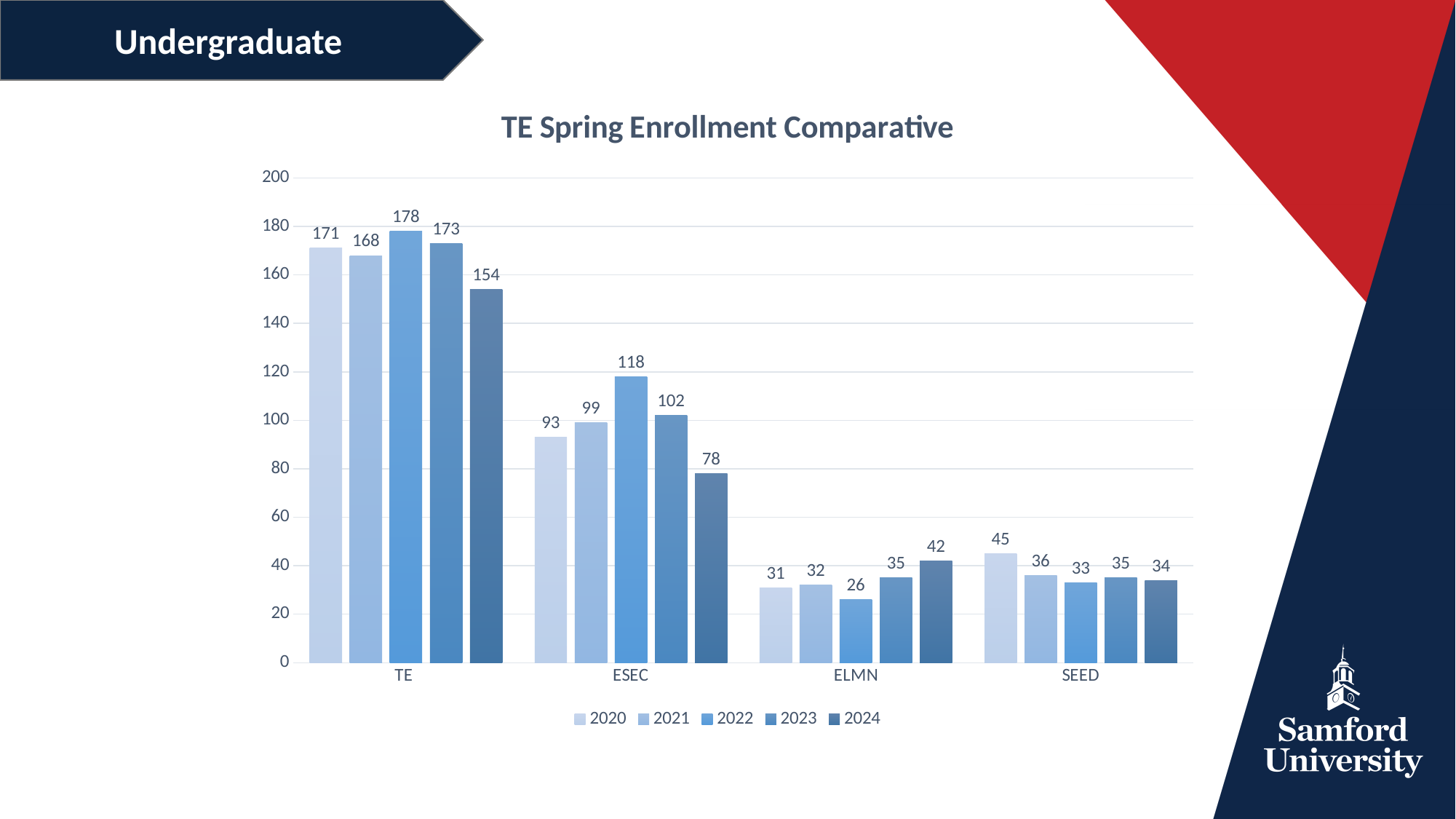
Which year has the lowest enrollment for TE? 2024 Which year has the highest enrollment for ELMN? 2024 What is the 2020 enrollment value for SEED? 45 What kind of chart is shown on the slide? Bar chart What is the title of the chart? TE Spring Enrollment Comparative What is the 2022 enrollment value for TE? 178 Do the SEED values rise or fall from 2020 to 2021? Fall Which is larger, the 2020 value for TE or the 2021 value for TE? 2020 value for TE How many categories are shown on the x axis? 4 What is the difference between the 2022 and 2024 enrollment values for ESEC? 40 How many series does the legend list? 5 What is the 2024 enrollment value for ESEC? 78